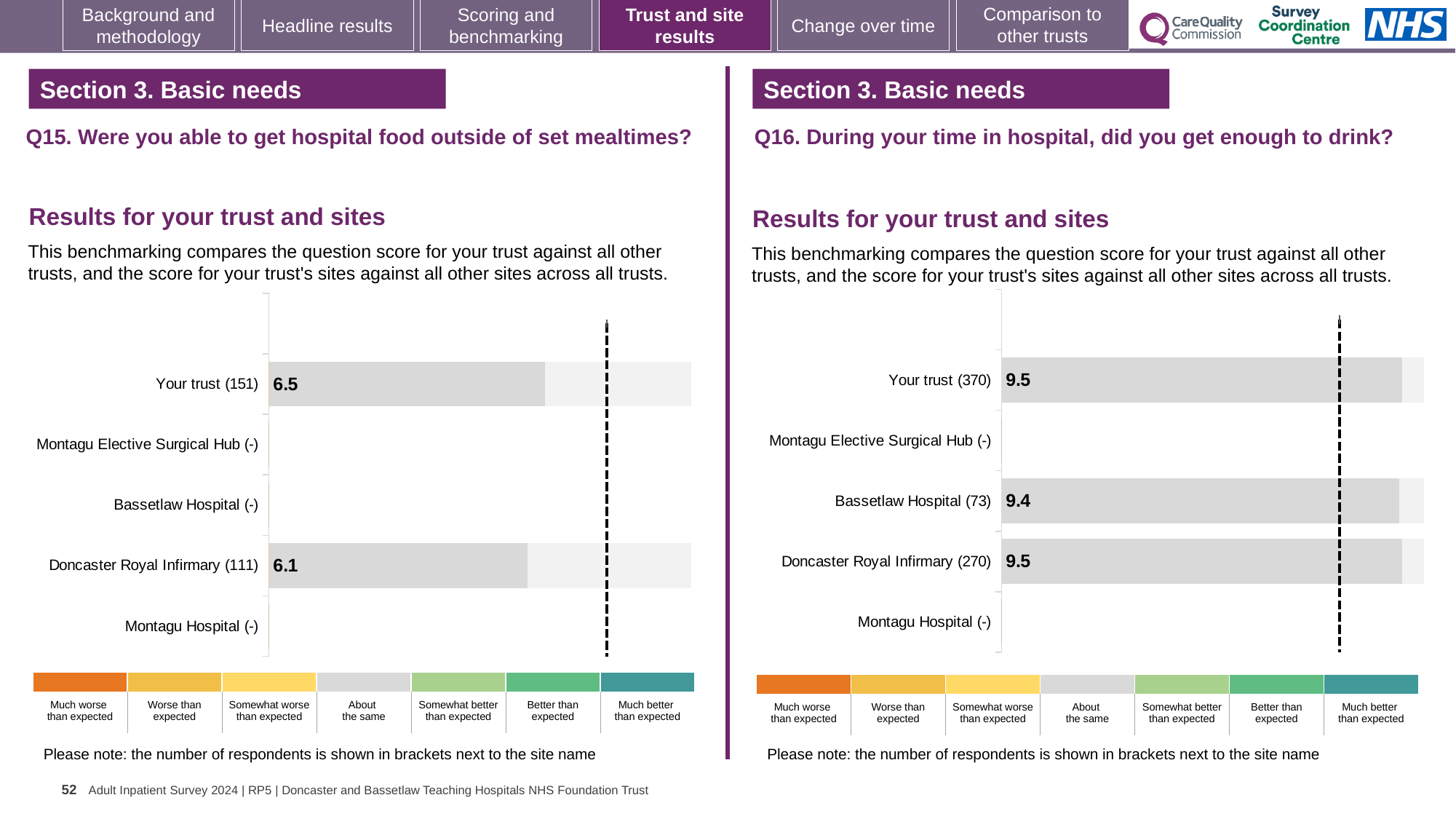
On the Q15 chart (left), what is the score for Doncaster Royal Infirmary? 6.1 On the Q16 chart (right), what is the score for Your trust? 9.5 On the Q15 chart (left), how many site or trust categories are listed on the vertical axis? 5 On the Q15 chart (left), what is the score for Your trust? 6.5 On the Q15 chart (left), which has the higher score, Your trust or Doncaster Royal Infirmary? Your trust What kind of chart is the Q16 chart (right)? Bar chart On the Q16 chart (right), what is the difference between the score for Your trust and the score for Bassetlaw Hospital? 0.1 On the Q16 chart (right), what is the score for Bassetlaw Hospital? 9.4 On the Q15 chart (left), how many respondents are shown in brackets for Your trust? 151 On the Q16 chart (right), what is the score for Doncaster Royal Infirmary? 9.5 On the Q16 chart (right), how many respondents are shown in brackets for Doncaster Royal Infirmary? 270 On the Q15 chart (left), what is the difference between the score for Your trust and the score for Doncaster Royal Infirmary? 0.4